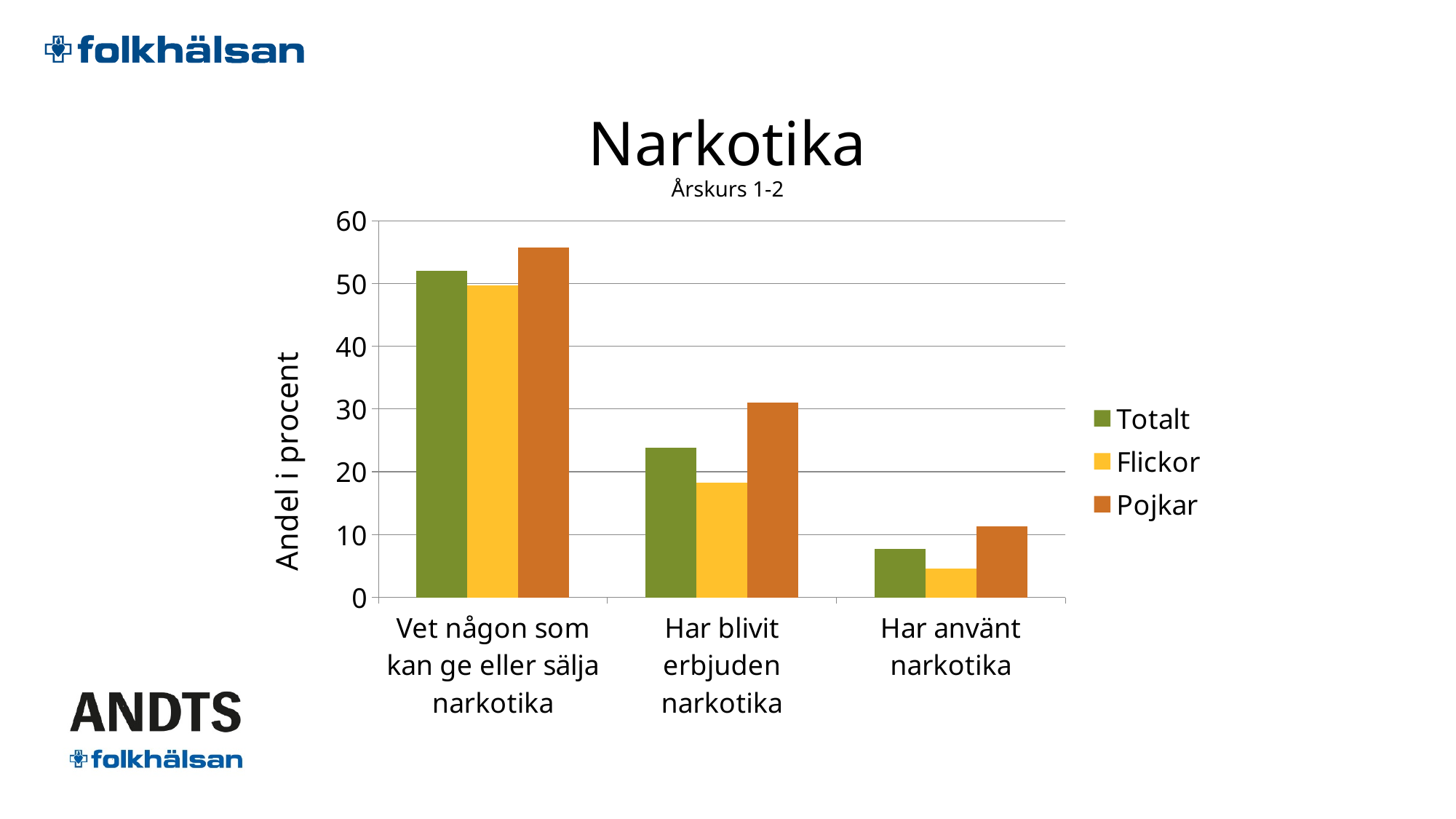
Is the value for Flickor in 'Har blivit erbjuden narkotika' greater or less than 20? less Which series has the highest bar in the category 'Vet någon som kan ge eller sälja narkotika'? Pojkar Which is larger in 'Har blivit erbjuden narkotika': Flickor or Pojkar? Pojkar How many series does the legend list? 3 Which series has the lowest bar in the category 'Har använt narkotika'? Flickor Which category has the highest values overall? Vet någon som kan ge eller sälja narkotika How many categories are shown on the x axis? 3 What is the label on the y axis? Andel i procent Do the values for Totalt rise or fall from left to right across the categories? fall What kind of chart is shown on the slide? bar chart Is the value for Totalt in 'Har använt narkotika' greater or less than 10? less Is the value for Pojkar in 'Vet någon som kan ge eller sälja narkotika' greater or less than 50? greater